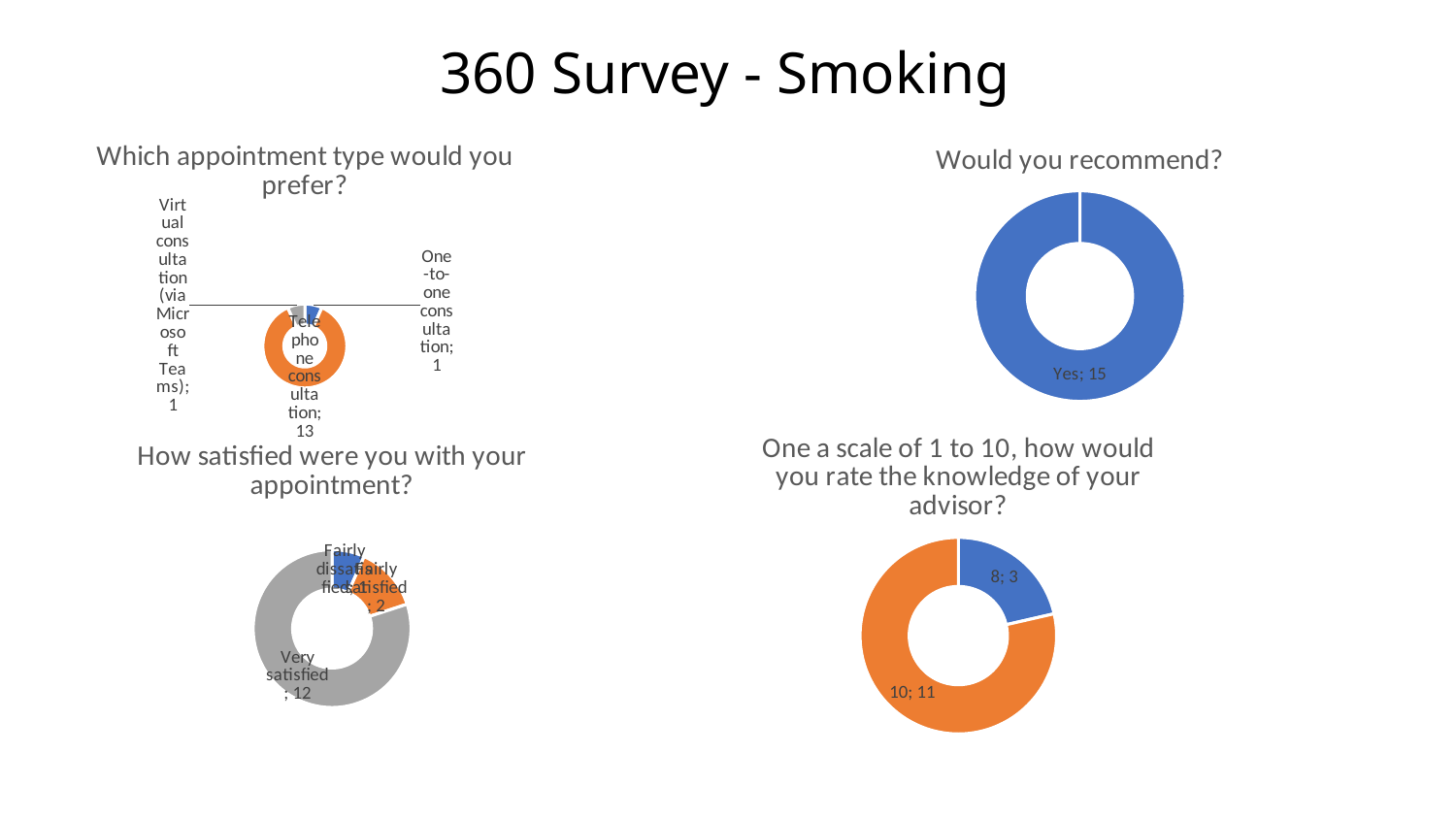
In the chart about rating the knowledge of your advisor, what is the difference between the number of respondents who rated 10 and those who rated 8? 8 In the chart titled "How satisfied were you with your appointment?", how many respondents were Fairly satisfied? 2 In the chart titled "Which appointment type would you prefer?", which appointment type has the highest count? Telephone consultation In the chart titled "How satisfied were you with your appointment?", how many respondents were Very satisfied? 12 In the chart titled "Which appointment type would you prefer?", what is the difference between the Telephone consultation count and the One-to-one consultation count? 12 In the chart about rating the knowledge of your advisor, how many respondents gave a rating of 8? 3 In the chart about rating the knowledge of your advisor, how many rating categories are shown? 2 In the chart titled "How satisfied were you with your appointment?", which is larger: Very satisfied or Fairly satisfied? Very satisfied What type of chart is used for "Would you recommend?"? Doughnut chart In the chart titled "Would you recommend?", what is the value shown for Yes? 15 In the chart about rating the knowledge of your advisor, how many respondents gave a rating of 10? 11 In the chart titled "Which appointment type would you prefer?", how many respondents chose Telephone consultation? 13